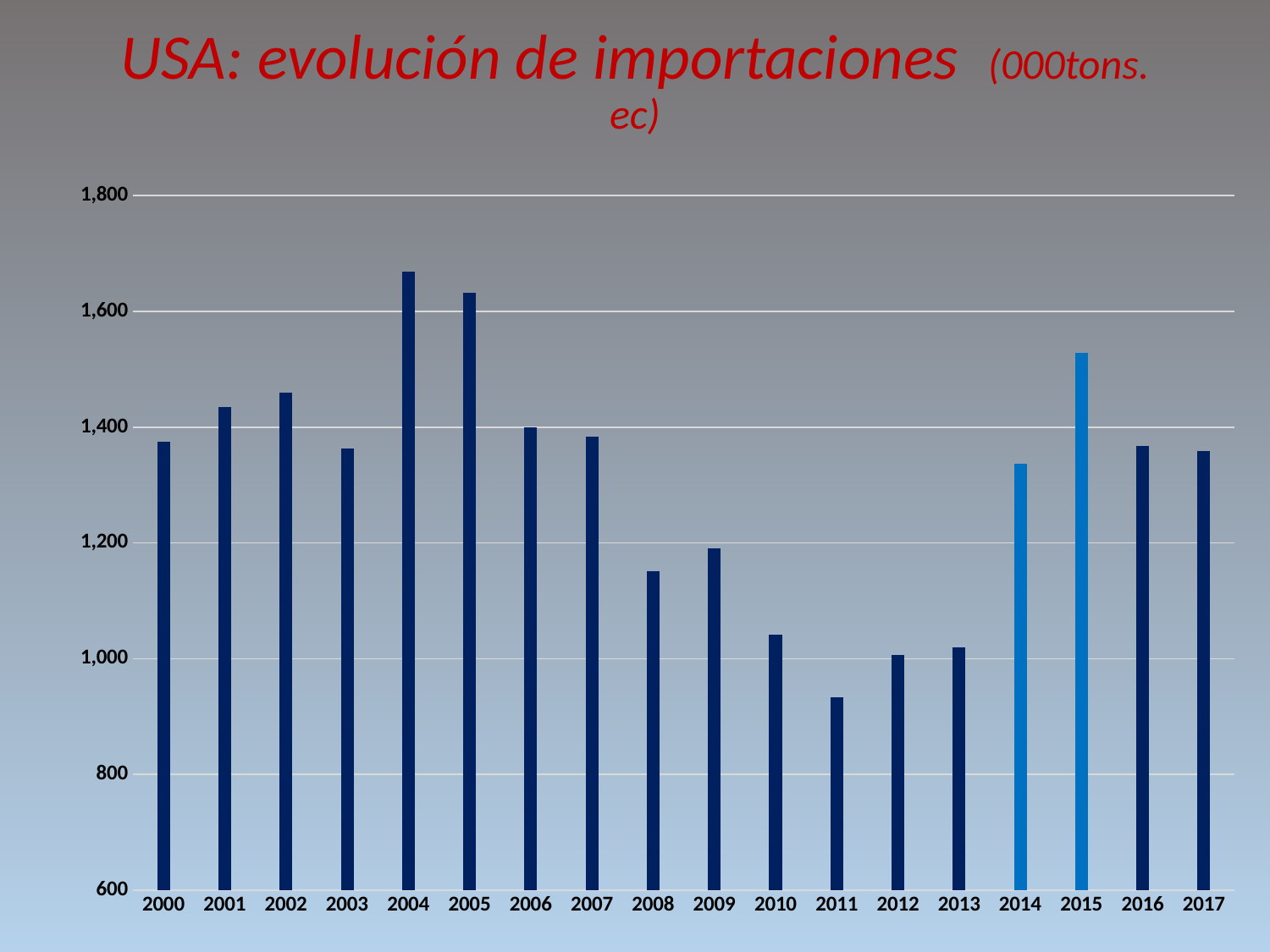
Is the value for 2015 greater or less than 1,400? greater Which two years are shown in a lighter blue colour than the other bars? 2014 and 2015 What kind of chart is shown on the slide? bar chart Do the values rise or fall from 2005 to 2011? fall Is the value for 2004 greater or less than 1,600? greater Which year has the larger value, 2014 or 2015? 2015 How many years are plotted on the x axis? 18 Is the value for 2014 greater or less than 1,400? less Which year has the highest import value? 2004 Which year has the lowest import value? 2011